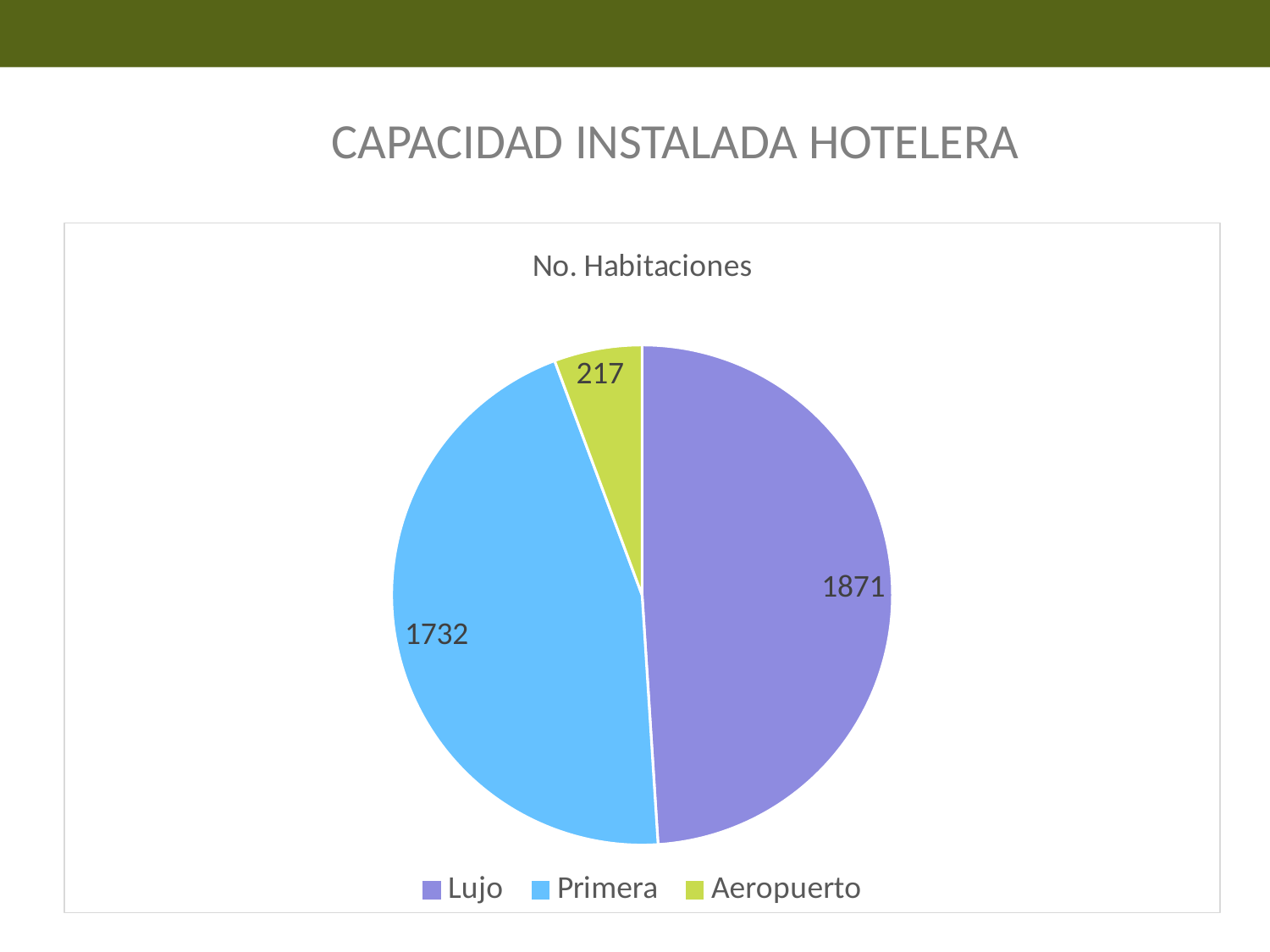
What is the difference between the values for Primera and Aeropuerto? 1515 What kind of chart is shown on the slide? Pie chart What is the difference between the values for Lujo and Primera? 139 Which is larger, the value for Lujo or the value for Primera? Lujo Which category has the largest slice in the No. Habitaciones pie chart? Lujo What is the title of the chart on the slide? No. Habitaciones What is the value for Primera in the No. Habitaciones pie chart? 1732 What is the value for Lujo in the No. Habitaciones pie chart? 1871 What is the value for Aeropuerto in the No. Habitaciones pie chart? 217 How many slices does the No. Habitaciones pie chart have? 3 What is the total of all slices in the No. Habitaciones pie chart? 3820 Which category has the smallest slice in the No. Habitaciones pie chart? Aeropuerto